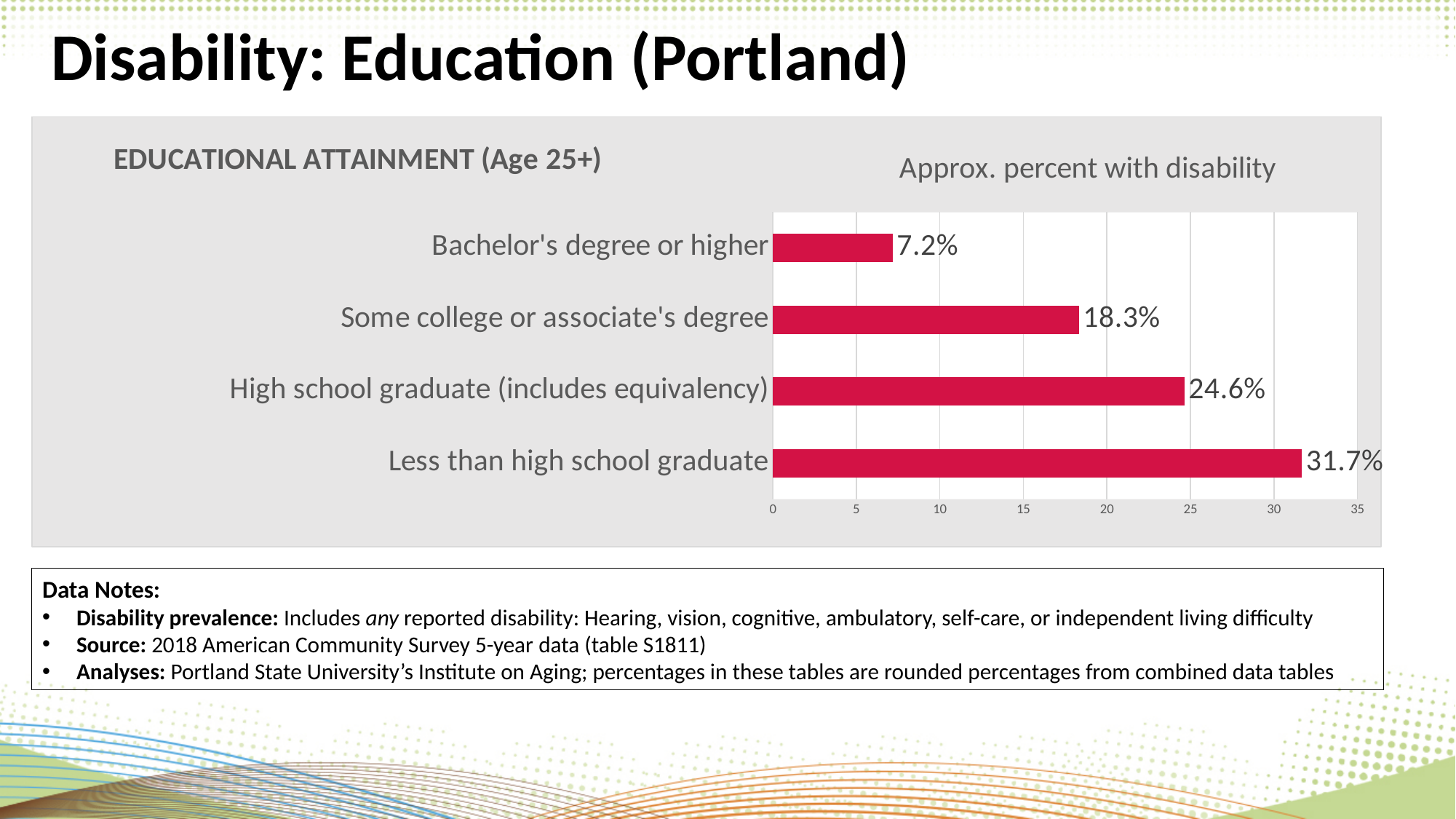
How many educational attainment categories are shown in the chart? 4 What type of chart is used to show the percent with disability by educational attainment? Bar chart What is the approximate percent with disability for people with a Bachelor's degree or higher? 7.2% What is the approximate percent with disability for people with some college or associate's degree? 18.3% What is the difference in percent with disability between 'Less than high school graduate' and 'Bachelor's degree or higher'? 24.5% Which educational attainment category has the lowest percent with disability? Bachelor's degree or higher What is the difference in percent with disability between 'High school graduate (includes equivalency)' and 'Some college or associate's degree'? 6.3% What is the approximate percent with disability for high school graduates (includes equivalency)? 24.6% Which has a higher percent with disability: 'Some college or associate's degree' or 'High school graduate (includes equivalency)'? High school graduate (includes equivalency) Which educational attainment category has the highest percent with disability? Less than high school graduate What is the approximate percent with disability for people with less than a high school graduate education? 31.7% What is the title shown above the chart's plot area? Approx. percent with disability